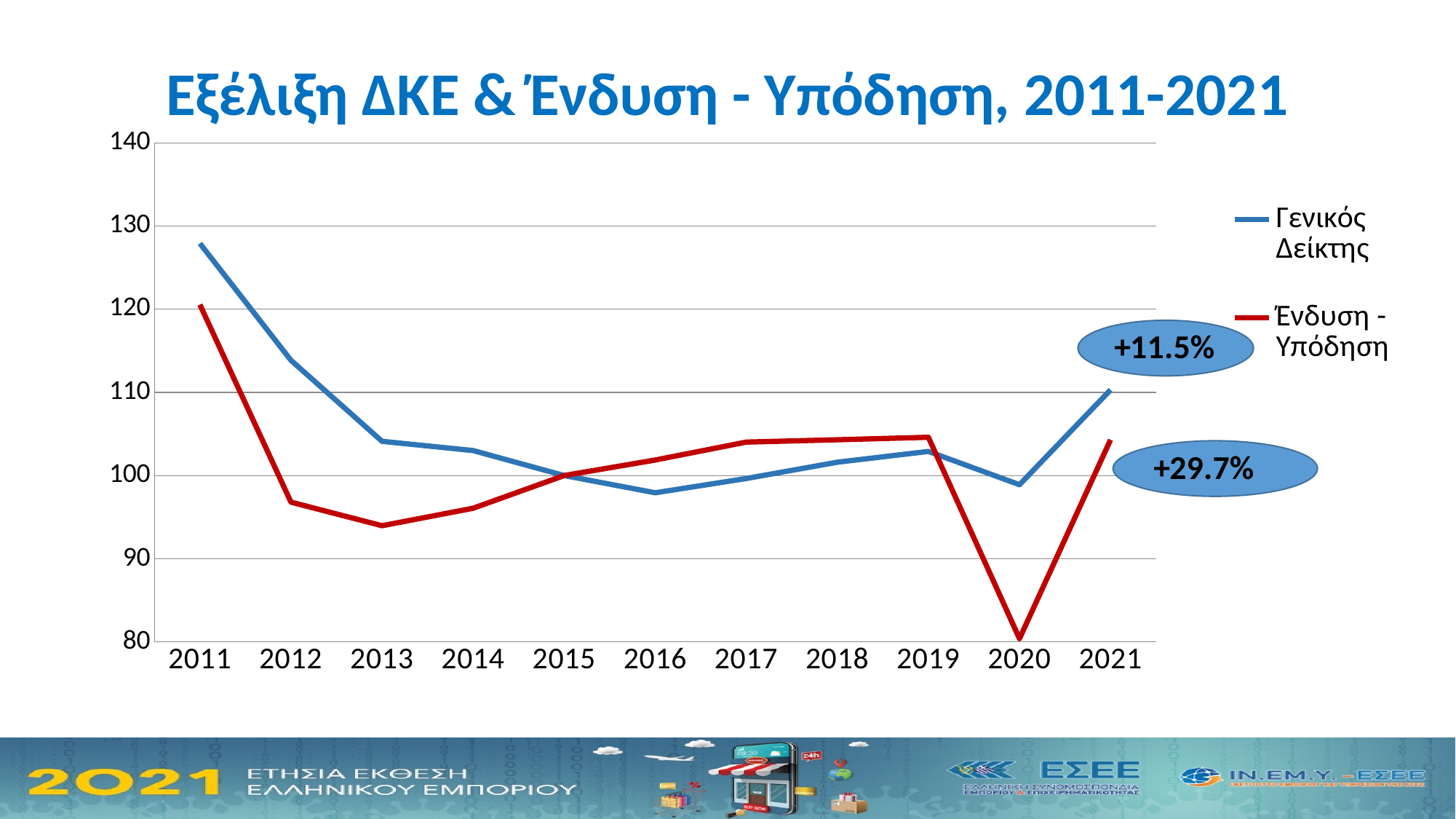
Is the value for Γενικός Δείκτης in 2011 greater or less than 120? greater In which year is the Γενικός Δείκτης series at its highest? 2011 In which year is the Ένδυση - Υπόδηση series at its highest? 2011 What kind of chart is shown on the slide? line chart How many years are plotted along the x axis? 11 Does the Ένδυση - Υπόδηση series rise or fall from 2019 to 2020? fall In which year is the Ένδυση - Υπόδηση series at its lowest? 2020 Is the value for Ένδυση - Υπόδηση in 2013 greater or less than 100? less How many series does the legend list? 2 In 2020, which series has the larger value, Γενικός Δείκτης or Ένδυση - Υπόδηση? Γενικός Δείκτης Is the value for Ένδυση - Υπόδηση in 2020 greater or less than 90? less What is the title of the chart? Εξέλιξη ΔΚΕ & Ένδυση - Υπόδηση, 2011-2021